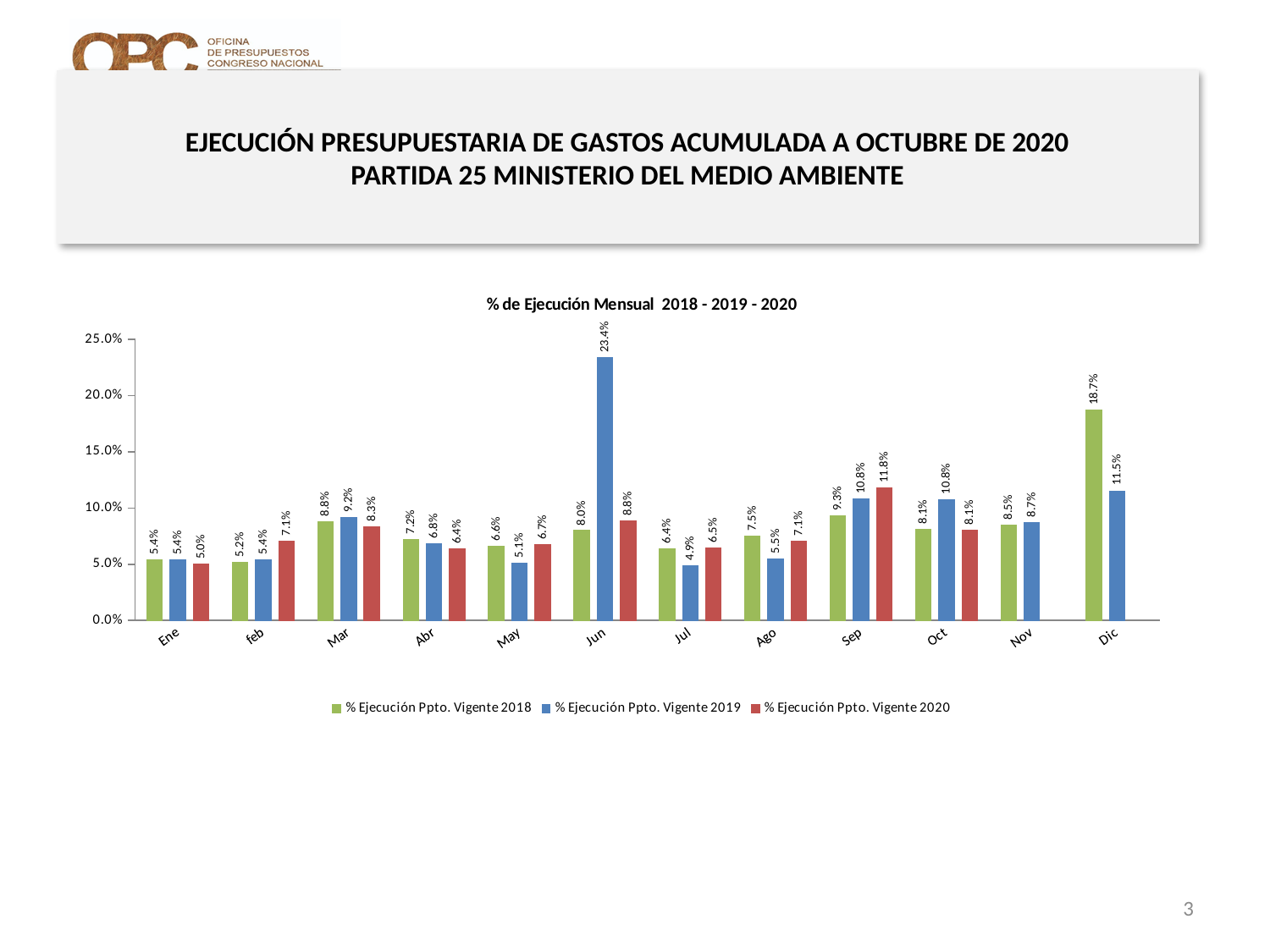
What is the value for % Ejecución Ppto. Vigente 2019 in Jun? 23.4% What is the value for % Ejecución Ppto. Vigente 2020 in feb? 7.1% What kind of chart is shown on the slide? Bar chart Which is larger in Dic: the 2018 value or the 2019 value? 2018 (18.7%) In which month is the % Ejecución Ppto. Vigente 2019 series highest? Jun In which month is the % Ejecución Ppto. Vigente 2019 series lowest? Jul What is the difference between the 2019 and 2018 values in Jun? 15.4% How many series does the legend list? 3 Is the value for % Ejecución Ppto. Vigente 2019 in Jun greater or less than 20.0%? greater How many months are shown on the x axis? 12 What is the value for % Ejecución Ppto. Vigente 2020 in Sep? 11.8% What is the value for % Ejecución Ppto. Vigente 2018 in Dic? 18.7%